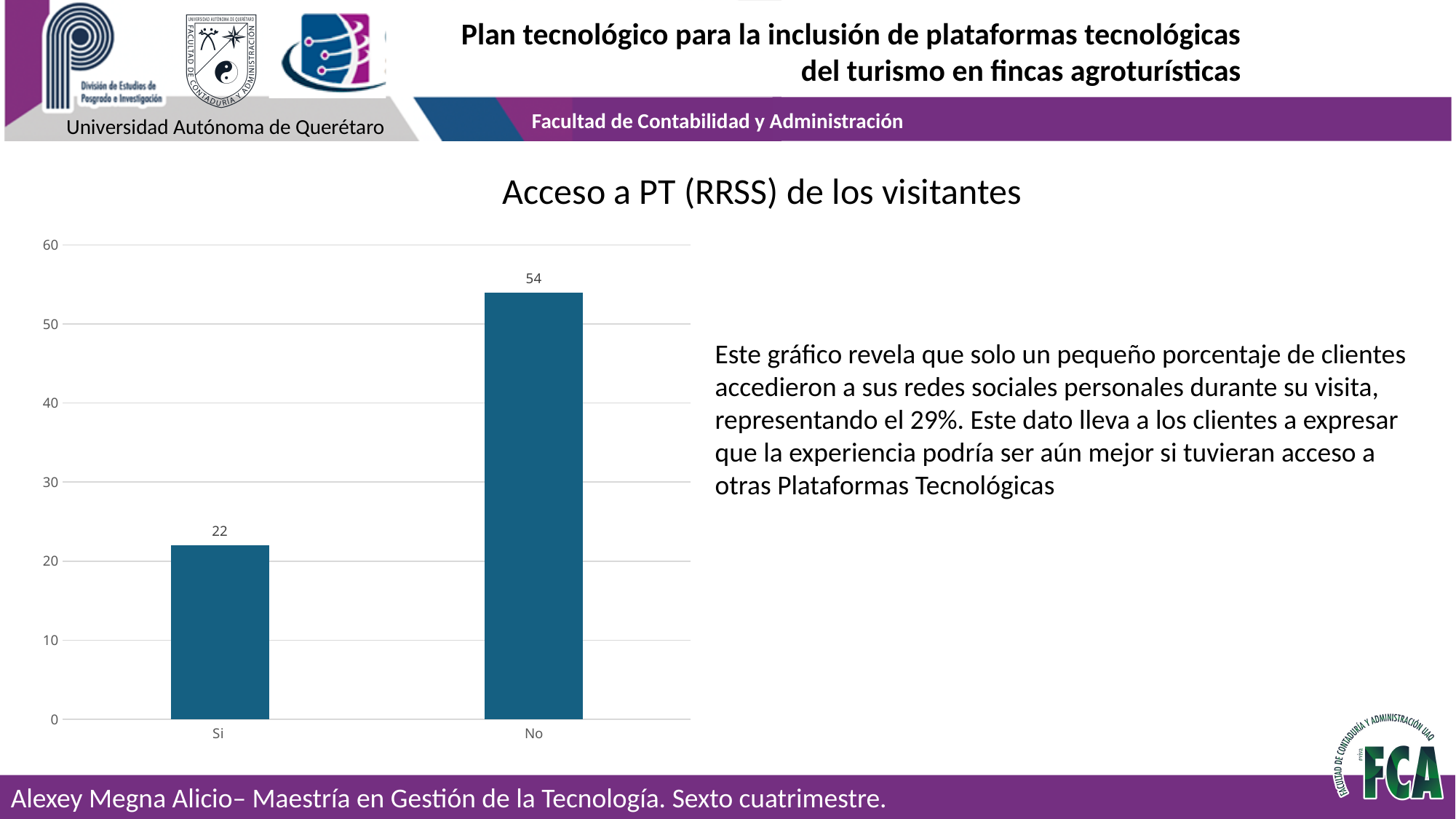
What is the value for "No"? 54 What is the highest value shown on the y axis? 60 Which category has the lowest value? Si Which is larger, the value for "Si" or the value for "No"? No Which category has the highest value? No Is the value for "Si" greater or less than 30? less What is the difference between the values for "No" and "Si"? 32 Is the value for "No" greater or less than 50? greater What is the value for "Si"? 22 What kind of chart is shown on the slide? bar chart How many categories are shown on the x axis? 2 What is the title of the chart? Acceso a PT (RRSS) de los visitantes